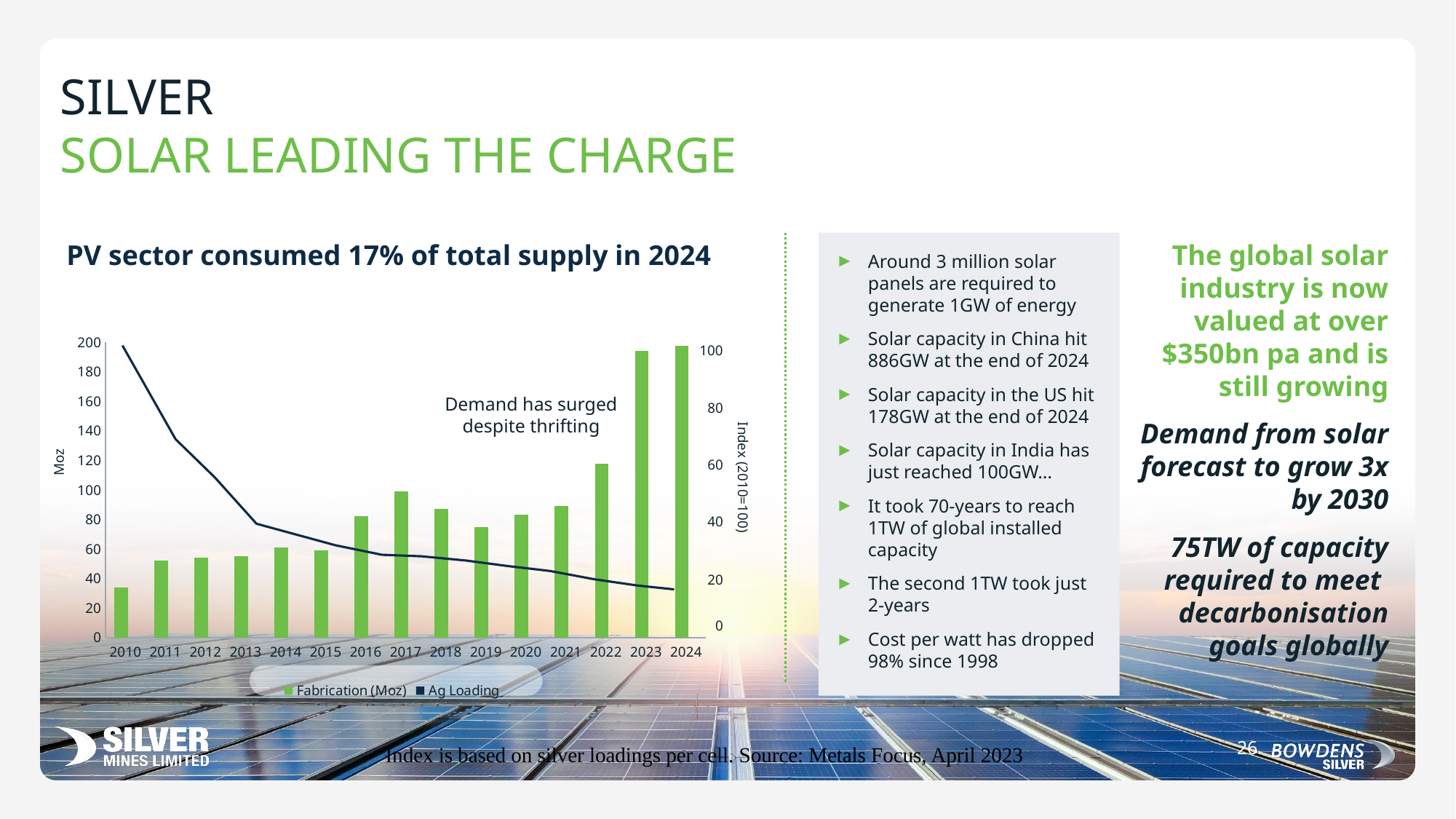
What are the two series named in the chart legend? Fabrication (Moz) and Ag Loading Is the Fabrication (Moz) value for 2010 greater or less than 40? less Is the Fabrication (Moz) value for 2022 greater or less than 100? greater Is the Fabrication (Moz) value for 2024 greater or less than 180? greater Does the Ag Loading line rise or fall from 2010 to 2024? Fall What is the title shown above the chart? PV sector consumed 17% of total supply in 2024 How many years are shown along the x axis of the chart? 15 Which year has the highest Fabrication (Moz) bar? 2024 Which year has the lowest Fabrication (Moz) bar? 2010 How many series does the chart legend list? 2 Which year has the larger Fabrication (Moz) bar, 2019 or 2022? 2022 What kind of chart is shown on the slide? A combined bar and line chart